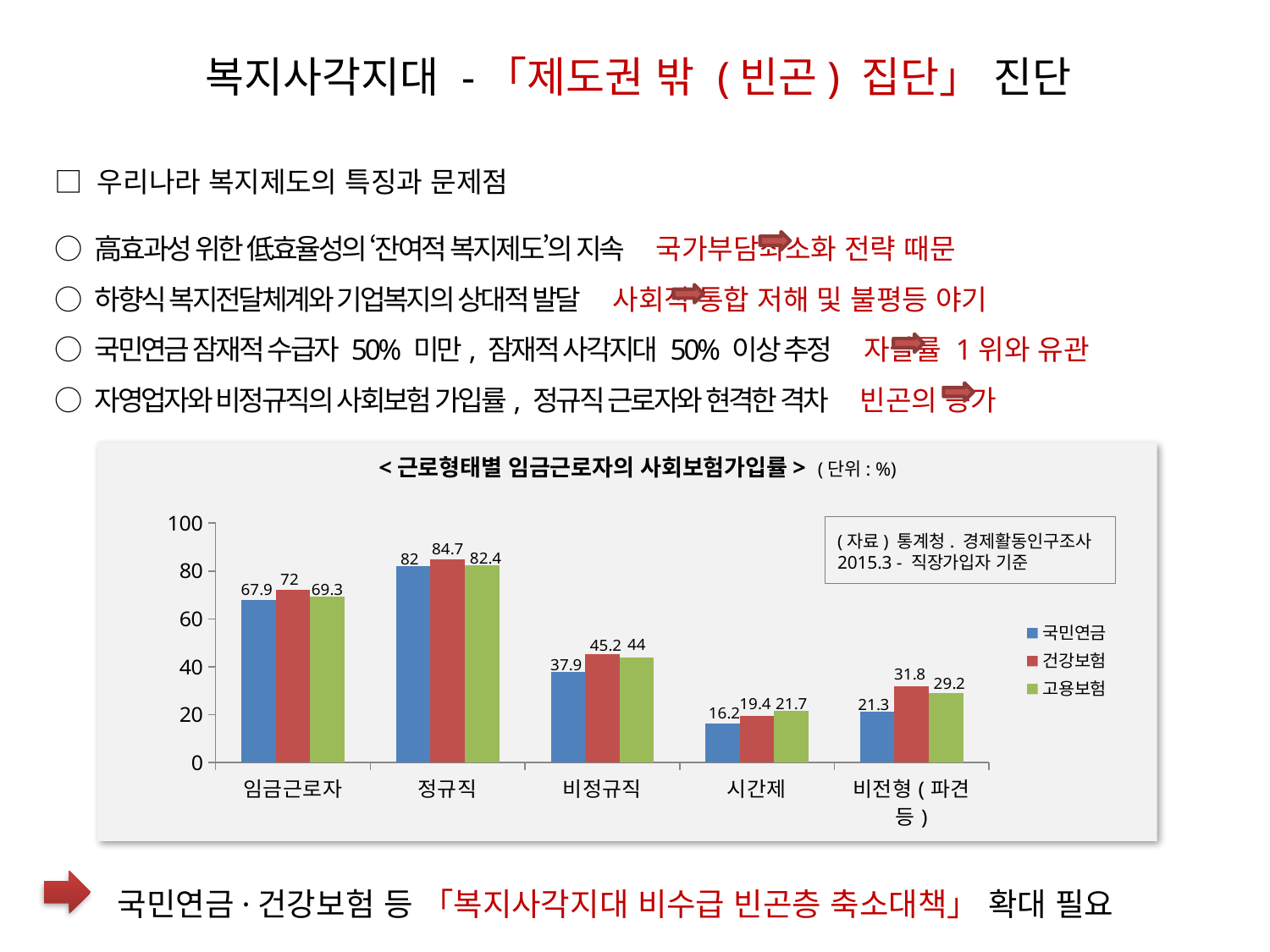
How many series does the legend list? 3 What is the 건강보험 value for 비정규직? 45.2 What is the 고용보험 value for 시간제? 21.7 Which category has the lowest 국민연금 value? 시간제 Which is larger for 임금근로자: the 건강보험 value or the 고용보험 value? 건강보험 Is the 국민연금 value for 비정규직 greater or less than 40? less What unit is indicated next to the chart title? % Which category has the highest 건강보험 value? 정규직 What is the difference between the 건강보험 and 국민연금 values for 비전형 (파견 등)? 10.5 What kind of chart is shown? bar chart What is the 국민연금 value for 정규직? 82 How many categories are shown on the x axis? 5